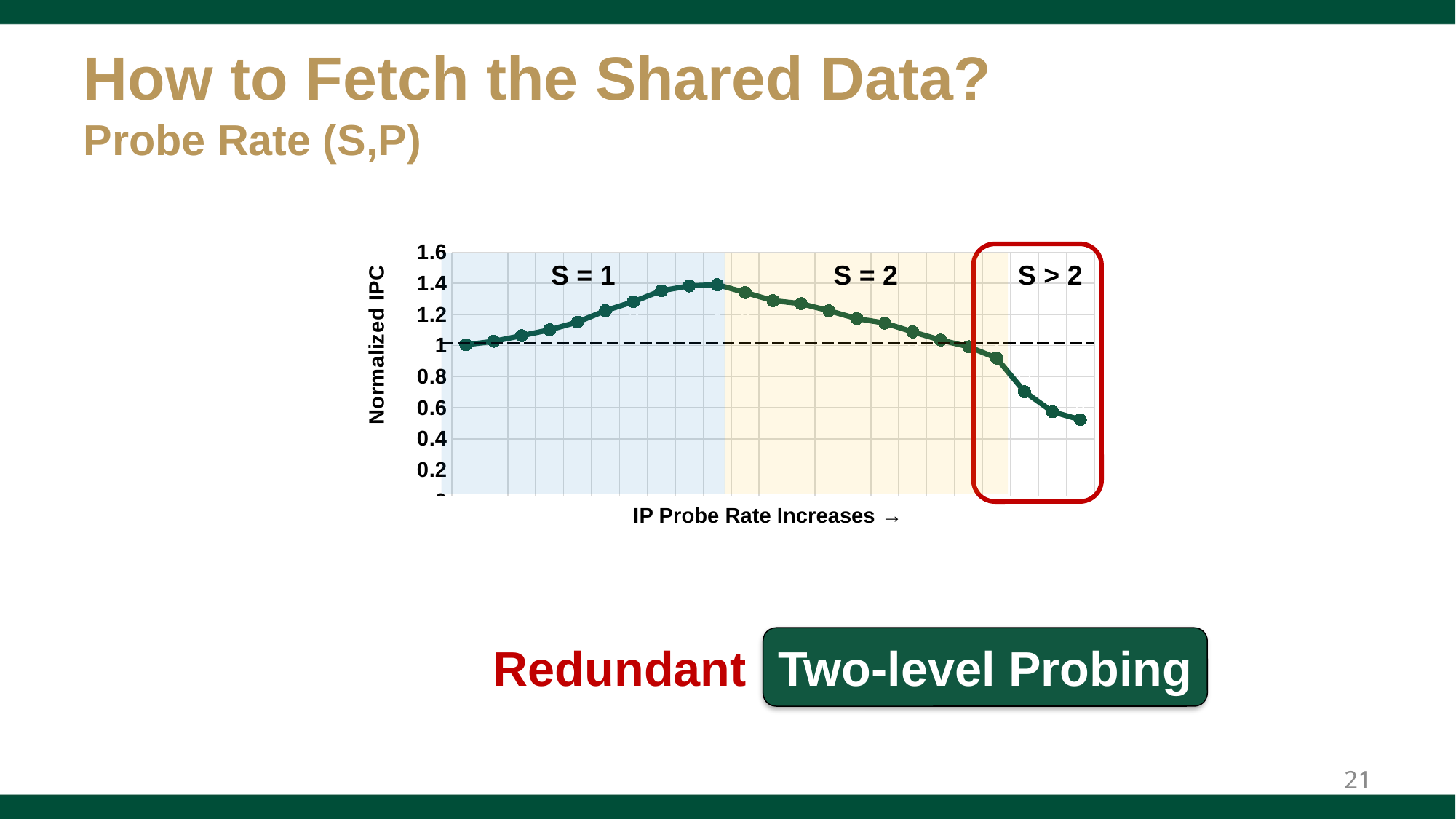
Which region of the chart is outlined with a red box? S > 2 What kind of chart is shown on the slide? line chart Is the Normalized IPC at the end of the S = 2 region greater or less than 1.2? less Which labelled region contains the lowest Normalized IPC values? S > 2 In the S = 1 region, do the Normalized IPC values rise or fall as the IP probe rate increases? rise Which is larger, the Normalized IPC at the peak of the S = 1 region or the Normalized IPC at the end of the S > 2 region? the peak of the S = 1 region Is the first (leftmost) Normalized IPC value on the chart greater or less than 1.2? less What is the label of the y axis of the chart? Normalized IPC Is the highest Normalized IPC value on the chart greater or less than 1.2? greater In the S = 2 region, do the Normalized IPC values rise or fall as the IP probe rate increases? fall In the S > 2 region, do the Normalized IPC values rise or fall as the IP probe rate increases? fall